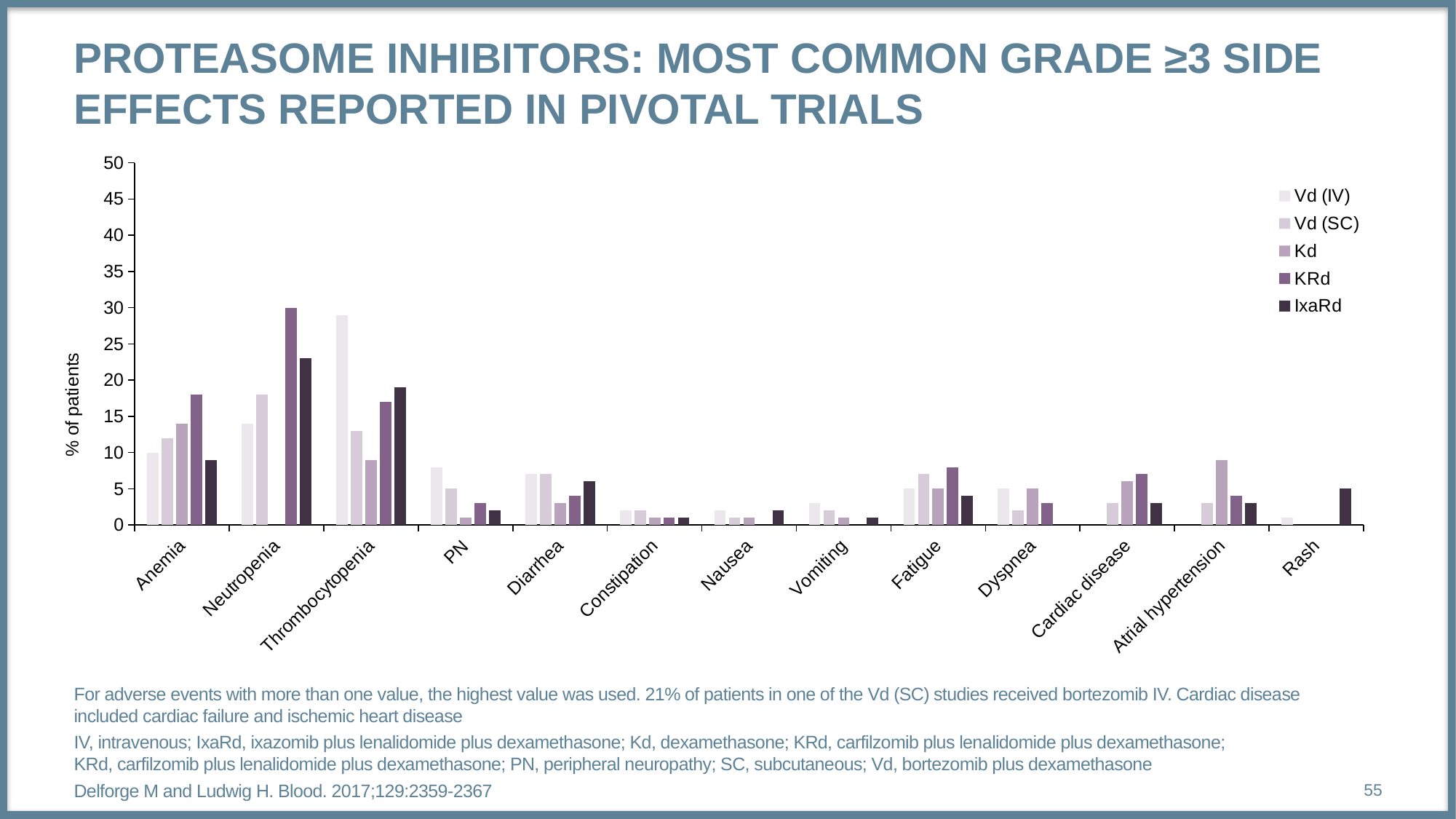
Which series has the highest value for Atrial hypertension? Kd Is the value for KRd in Neutropenia greater or less than 25? greater Is the value for IxaRd in Neutropenia greater or less than 20? greater How many series does the legend list? 5 How many side-effect categories are shown on the x axis? 13 Which series has the highest value for Neutropenia? KRd What is the label on the y axis of the chart? % of patients For Thrombocytopenia, which is larger: the Vd (IV) value or the Kd value? Vd (IV) Which series has the highest value for Thrombocytopenia? Vd (IV) Is the value for Vd (IV) in Thrombocytopenia greater or less than 25? greater What kind of chart is shown on the slide? bar chart For Anemia, which is larger: the KRd value or the IxaRd value? KRd